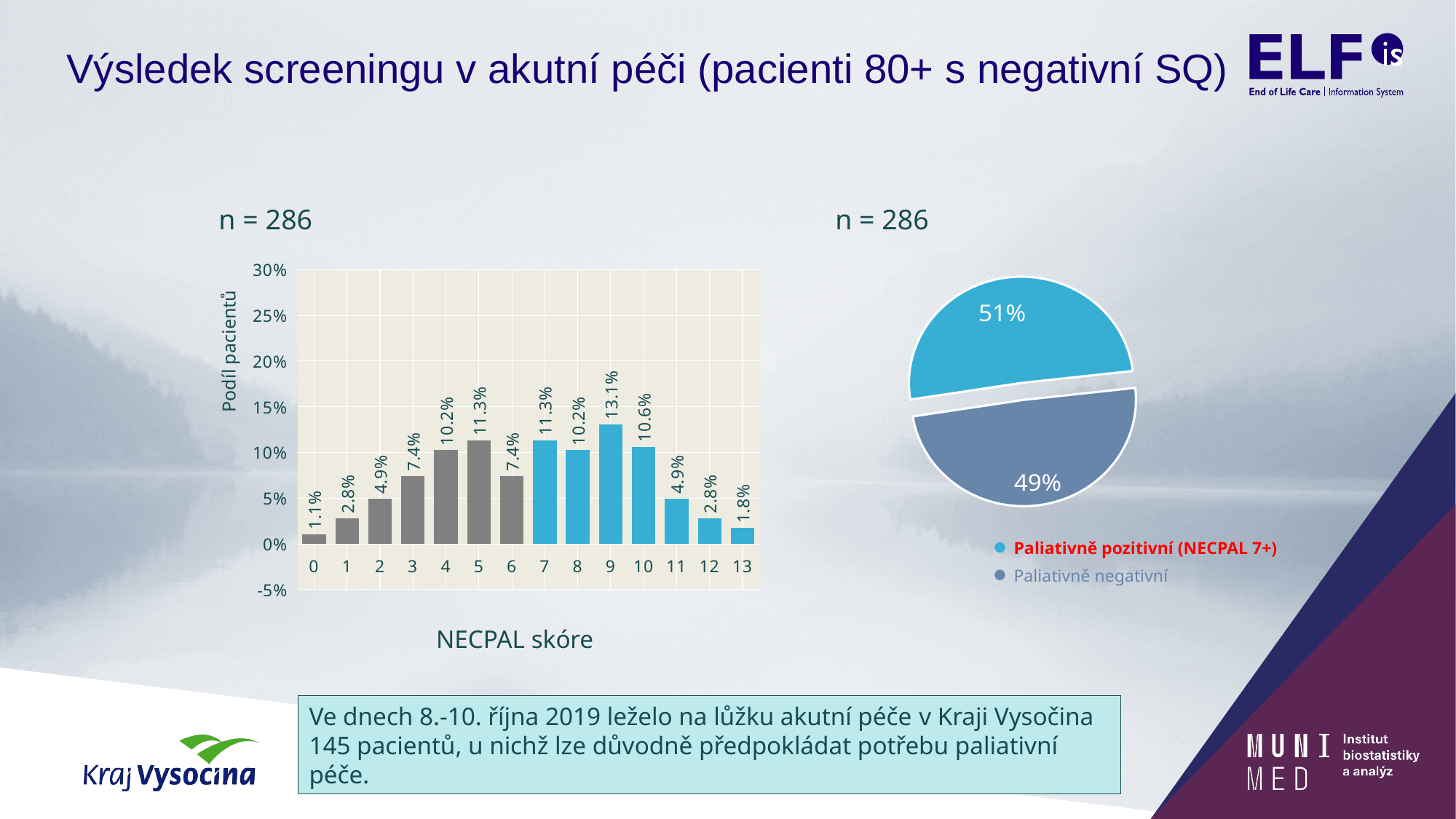
What is the x-axis label of the bar chart on the left? NECPAL skóre In the bar chart on the left, what is the share of patients with a NECPAL score of 9? 13.1% In the pie chart on the right, what share is labelled 'Paliativně pozitivní (NECPAL 7+)'? 51% In the bar chart on the left, which NECPAL score has the highest share of patients? 9 How many entries does the legend of the pie chart on the right list? 2 In the pie chart on the right, what share is labelled 'Paliativně negativní'? 49% In the bar chart on the left, what is the difference between the shares for NECPAL scores 9 and 13? 11.3% In the bar chart on the left, which NECPAL score has the lowest share of patients? 0 What kind of chart is shown on the left of the slide? Bar chart In the bar chart on the left, which has a larger share of patients: NECPAL score 4 or NECPAL score 11? NECPAL score 4 In the bar chart on the left, what is the share of patients with a NECPAL score of 0? 1.1% In the bar chart on the left, how many NECPAL score categories are shown on the x axis? 14